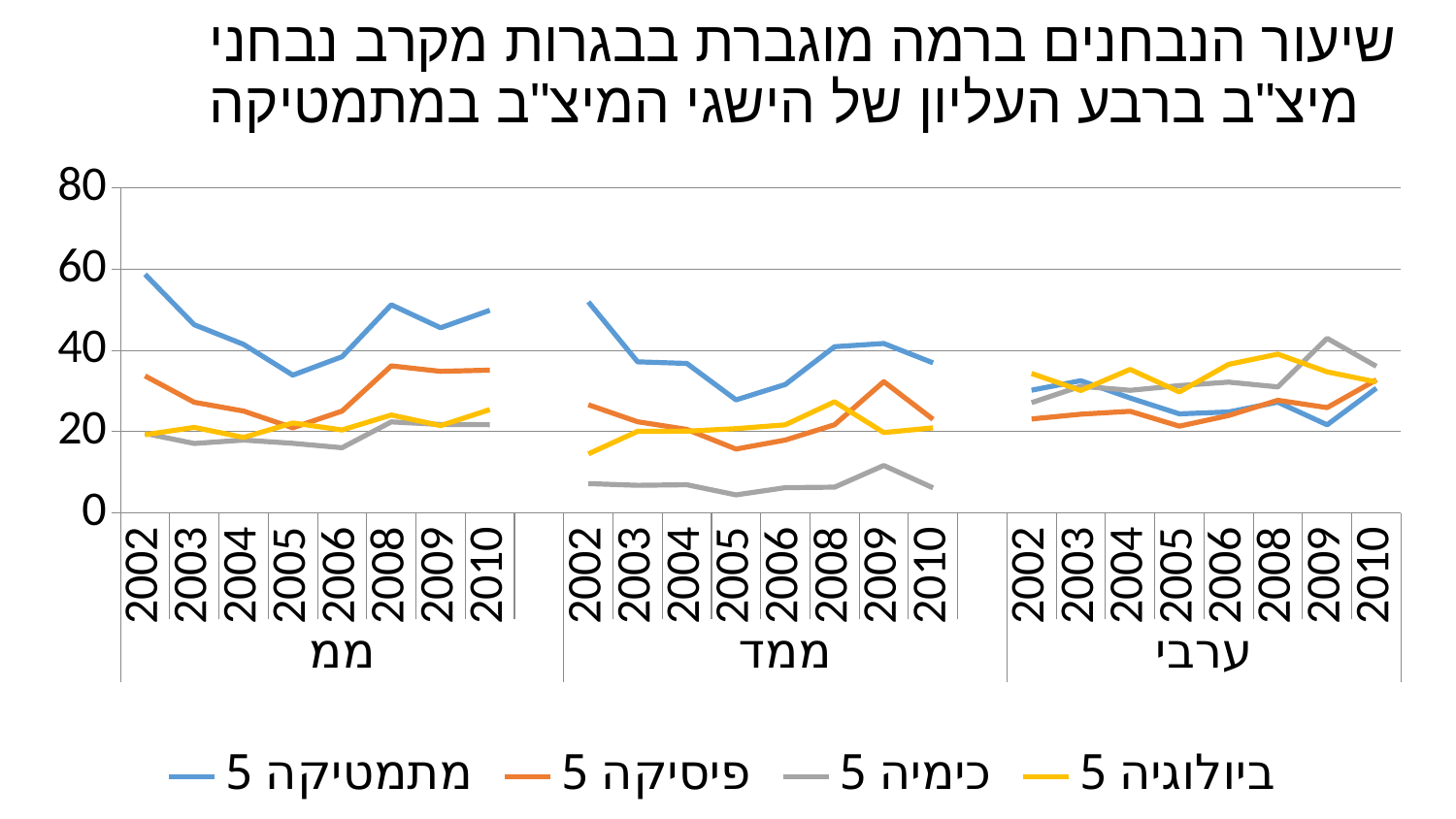
In the ממד group, which series has the lowest values across all years? כימיה 5 In the ממ group in 2002, which is larger: מתמטיקה 5 or פיסיקה 5? מתמטיקה 5 Is the value for כימיה 5 in the ממד group in 2005 greater or less than 20? less Does the מתמטיקה 5 line in the ממ group rise or fall from 2002 to 2005? fall How many years are plotted within the ממ group? 8 In the ממ group in 2002, which series has the highest value? מתמטיקה 5 In the ערבי group in 2009, which series has the highest value? כימיה 5 Is the value for מתמטיקה 5 in the ממ group in 2002 greater or less than 40? greater Is the value for ביולוגיה 5 in the ממד group in 2002 greater or less than 20? less How many sector groups are shown along the x axis? 3 What kind of chart is shown on the slide? line chart How many series does the legend list? 4